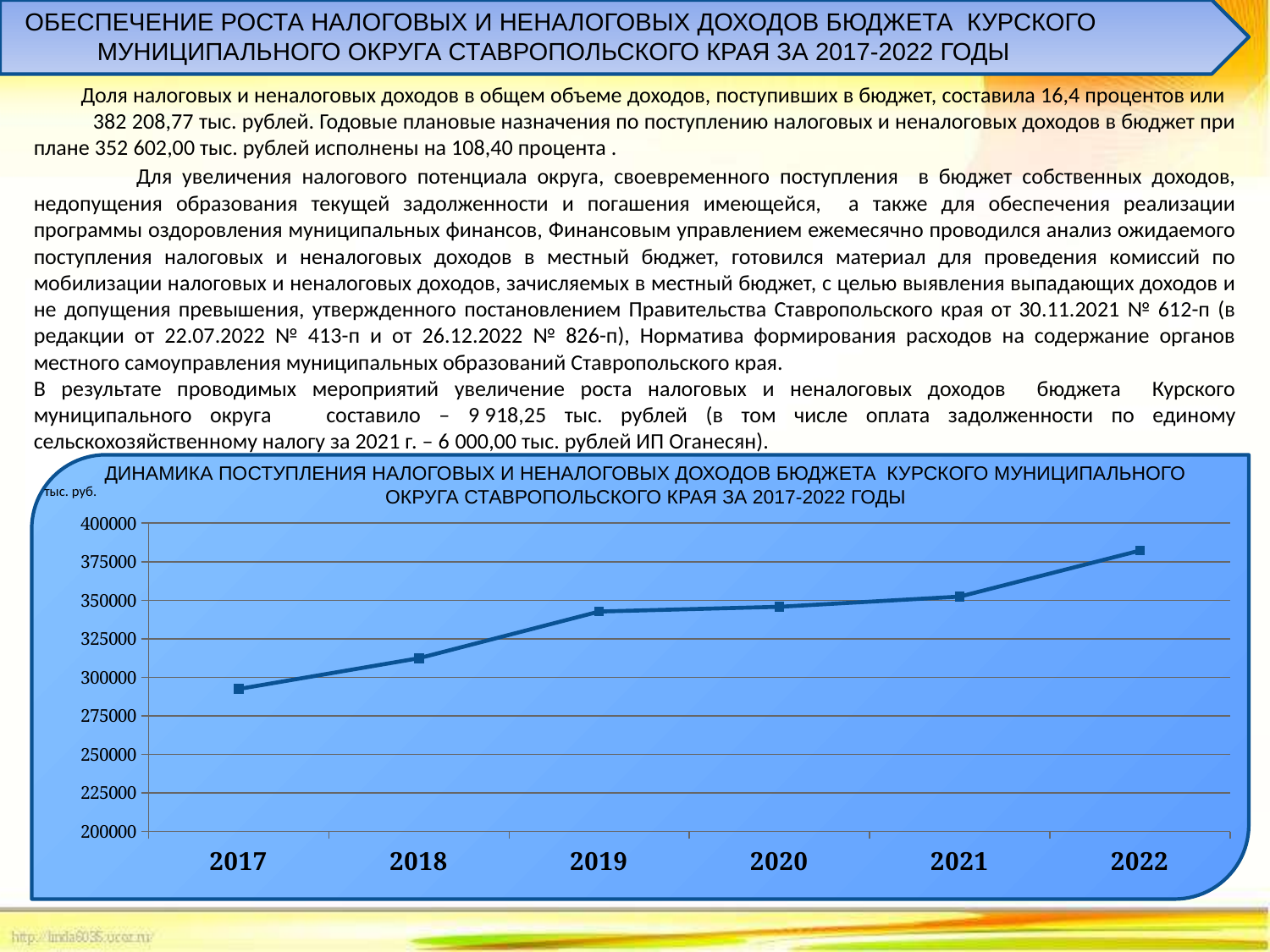
What is the title of the chart? ДИНАМИКА ПОСТУПЛЕНИЯ НАЛОГОВЫХ И НЕНАЛОГОВЫХ ДОХОДОВ БЮДЖЕТА КУРСКОГО МУНИЦИПАЛЬНОГО ОКРУГА СТАВРОПОЛЬСКОГО КРАЯ ЗА 2017-2022 ГОДЫ Is the value for 2019 greater or less than 325000? greater Is the value for 2017 greater or less than 300000? less Which year has the larger value, 2018 or 2019? 2019 Which year has the lowest value in the chart? 2017 Do the values rise or fall from 2017 to 2022? rise What kind of chart is shown on the slide? line chart What unit is shown at the top of the y axis of the chart? тыс. руб. Is the value for 2022 greater or less than 375000? greater How many years are plotted on the x axis of the chart? 6 Which year has the highest value in the chart? 2022